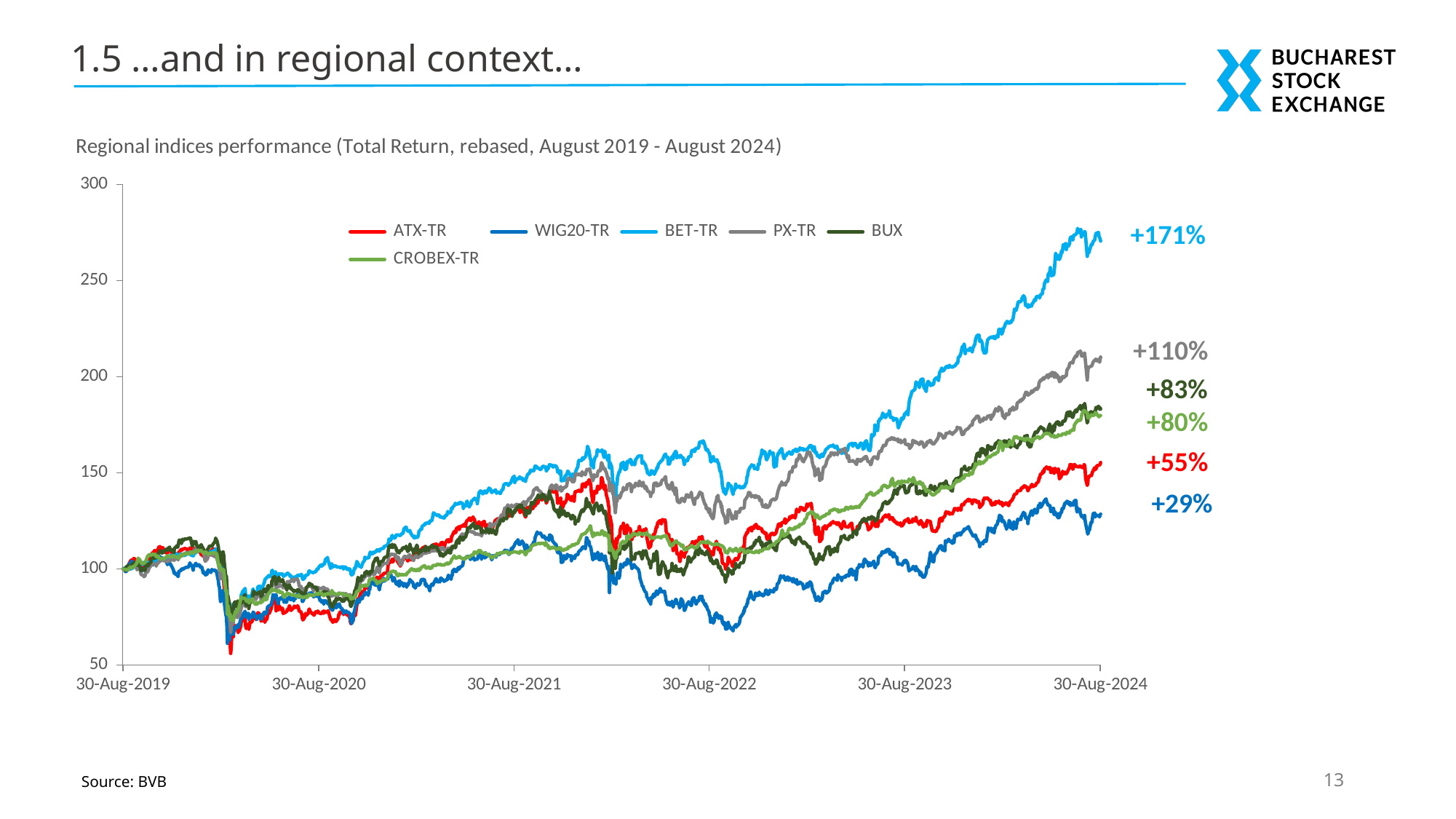
What kind of chart is shown on the slide? line chart Which has the larger labelled total return, BUX or CROBEX-TR? BUX What total return is labelled for WIG20-TR at the end of the period? +29% Which index has the lowest labelled total return over the period? WIG20-TR What total return is labelled for PX-TR at the end of the period? +110% How many series does the legend list? 6 What total return is labelled for ATX-TR at the end of the period? +55% What is the difference in percentage points between the labelled returns of BET-TR and PX-TR? 61 percentage points Is the BET-TR line at 30-Aug-2024 greater or less than 250? greater Which index has the highest labelled total return over the period? BET-TR What total return is labelled for BET-TR at the end of the period? +171% What is the title of the chart? Regional indices performance (Total Return, rebased, August 2019 - August 2024)